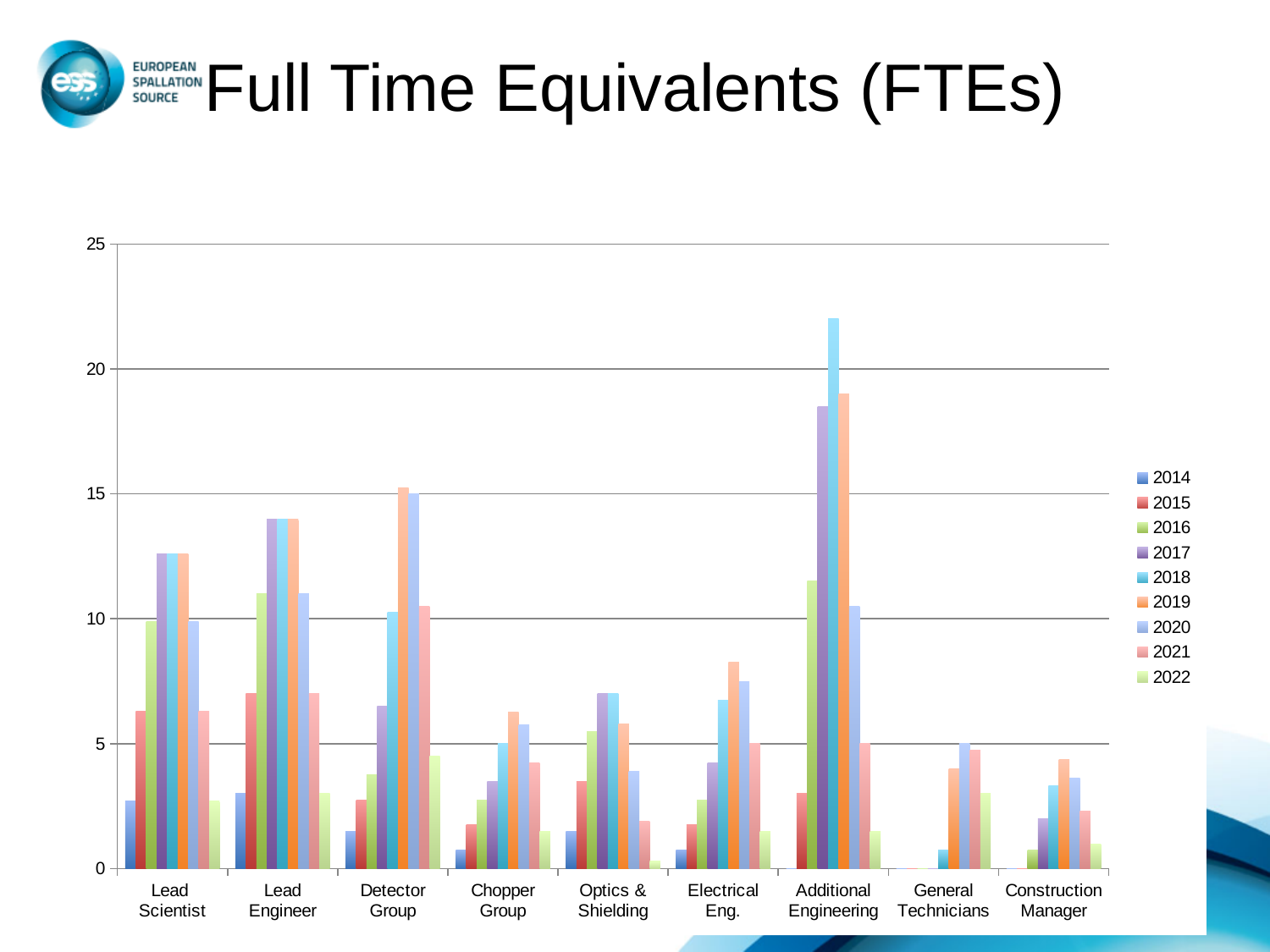
Which category contains the tallest bar in the chart? Additional Engineering Is the value for Electrical Eng. in 2019 greater or less than 5? greater Is the value for Additional Engineering in 2018 greater or less than 20? greater What is the title of the chart? Full Time Equivalents (FTEs) How many categories are shown along the x axis? 9 Is the value for Construction Manager in 2019 greater or less than 5? less How many series does the legend list? 9 Which is larger for Lead Scientist, the 2014 value or the 2015 value? 2015 Which is larger for Additional Engineering, the 2019 value or the 2020 value? 2019 What kind of chart is shown on the slide? bar chart Within the Detector Group category, which year has the lowest value? 2014